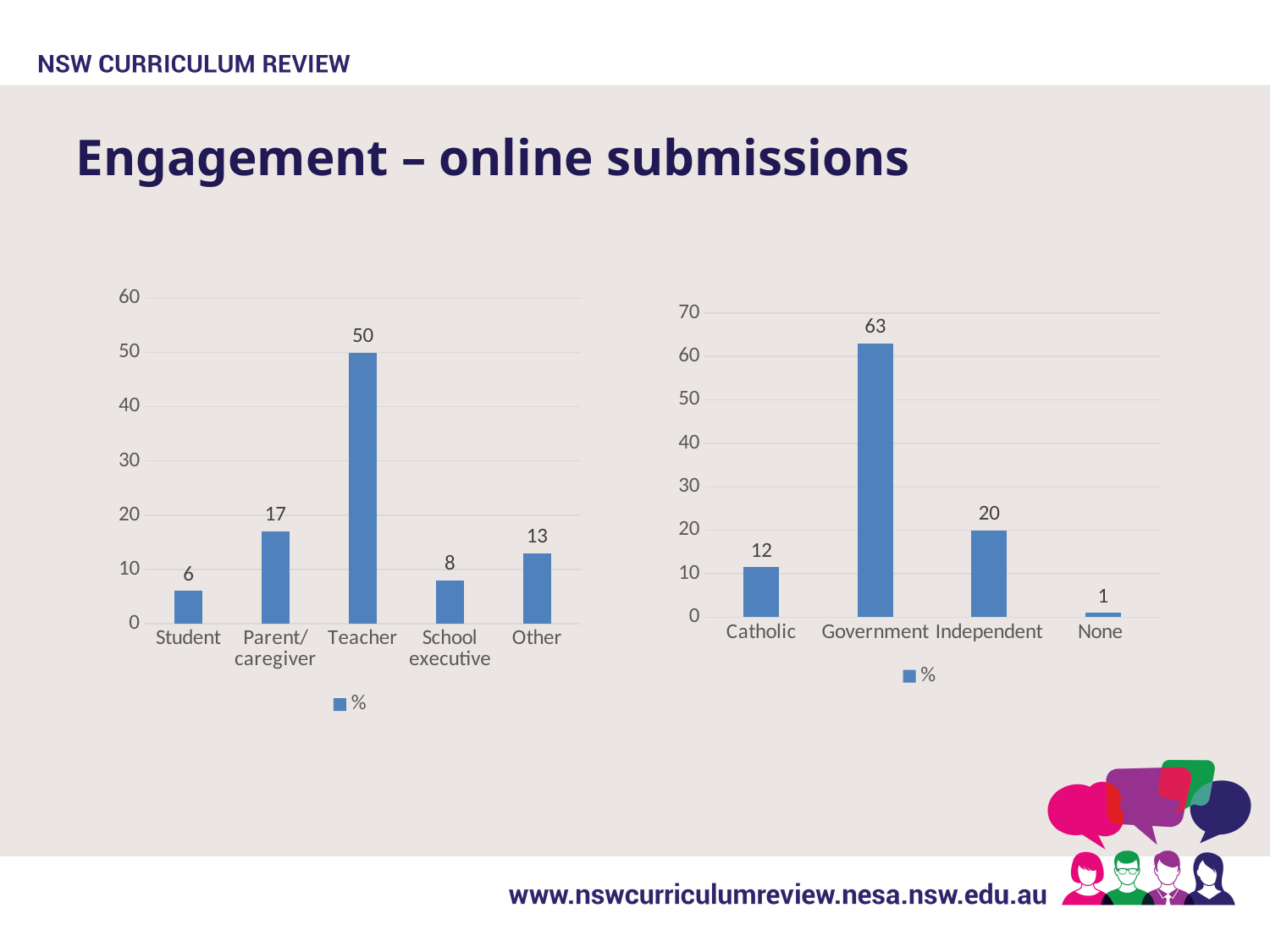
What kind of chart is the right chart? Bar chart In the left chart, what is the value for Teacher? 50 In the right chart, what is the difference between the values for Independent and Catholic? 8 In the left chart, what is the value for Parent/caregiver? 17 In the left chart, which category has the lowest value? Student In the right chart, what is the value for None? 1 In the left chart, what is the difference between the values for Teacher and Other? 37 In the right chart, which category has the highest value? Government In the left chart, which is larger, the value for School executive or the value for Other? Other In the right chart, how many series does the legend list? 1 In the left chart, how many categories are shown on the x axis? 5 In the right chart, what is the value for Government? 63